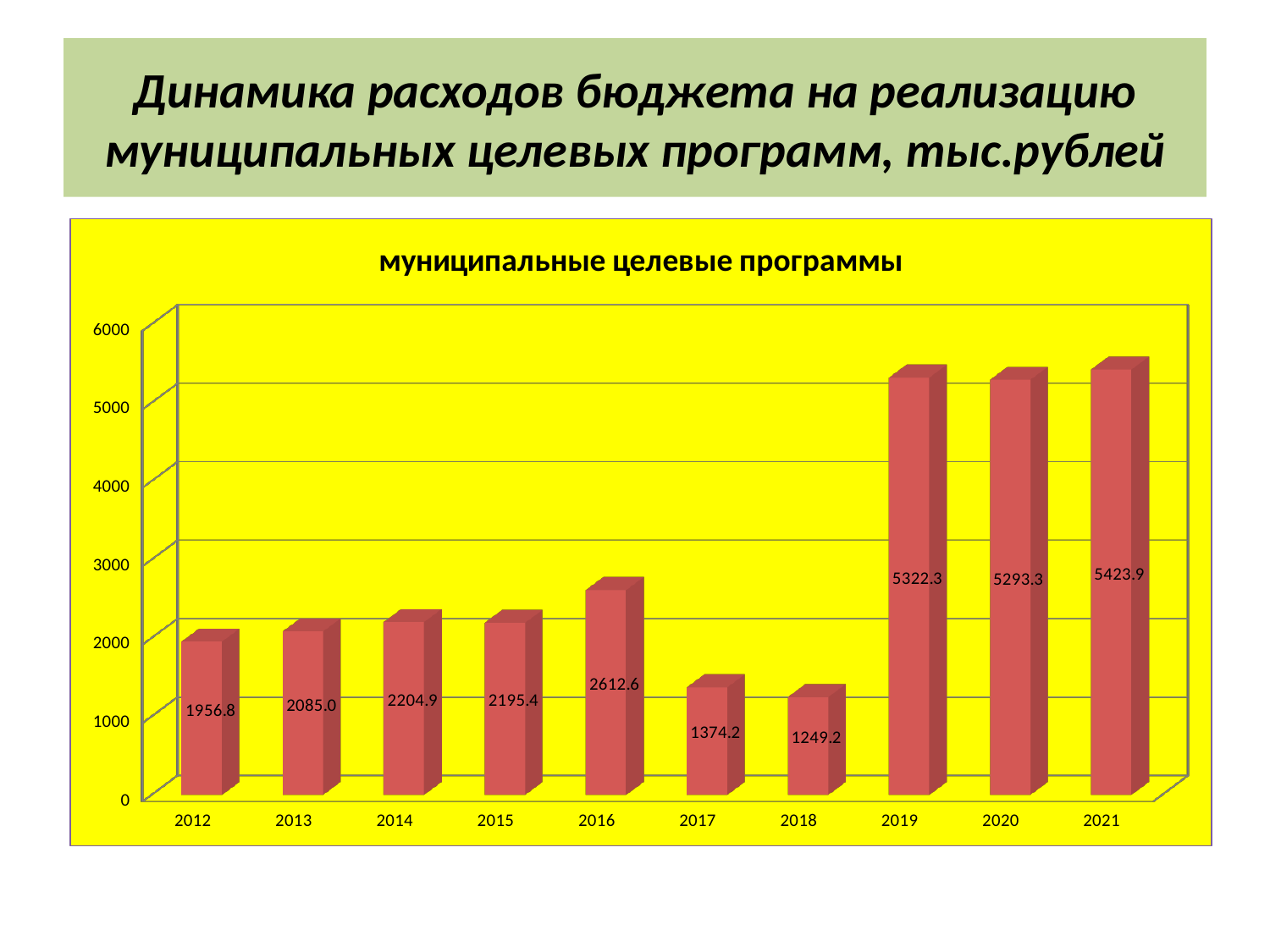
What is the value for 2020? 5293.3 What is the value for 2012? 1956.8 Which year has the highest value? 2021 What kind of chart is this? bar chart What is the difference between the values for 2021 and 2020? 130.6 What is the value for 2016? 2612.6 Which year has the lowest value? 2018 What is the value for 2018? 1249.2 What is the title of the chart? муниципальные целевые программы What is the difference between the values for 2017 and 2018? 125.0 How many years are shown on the x axis? 10 Which is larger, the value for 2014 or the value for 2015? 2014